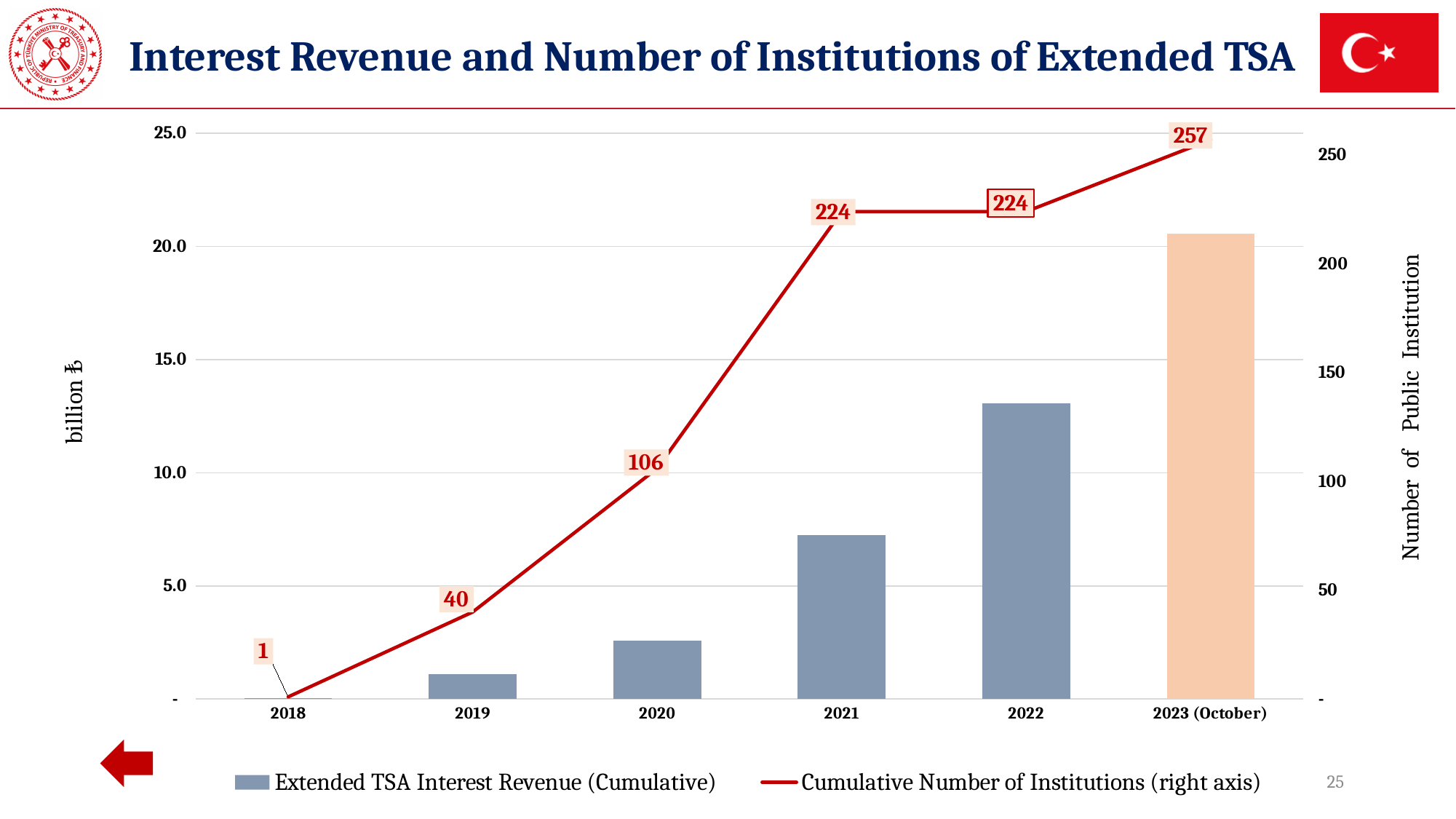
What is the cumulative number of institutions shown for 2020? 106 What is the cumulative number of institutions shown for 2023 (October)? 257 By how much did the cumulative number of institutions increase from 2022 to 2023 (October)? 33 How many series does the legend list? 2 What is the cumulative number of institutions shown for 2019? 40 Is the Extended TSA Interest Revenue (Cumulative) for 2022 greater or less than 10.0 billion ₺? greater What is the difference in the cumulative number of institutions between 2021 and 2020? 118 Does the Cumulative Number of Institutions rise or fall from 2018 to 2023 (October)? rise Which year has the highest Extended TSA Interest Revenue (Cumulative) bar? 2023 (October) Is the Extended TSA Interest Revenue (Cumulative) for 2020 greater or less than 5.0 billion ₺? less Which year has the lowest Extended TSA Interest Revenue (Cumulative) bar? 2018 Which year has the larger Extended TSA Interest Revenue (Cumulative) bar, 2021 or 2022? 2022